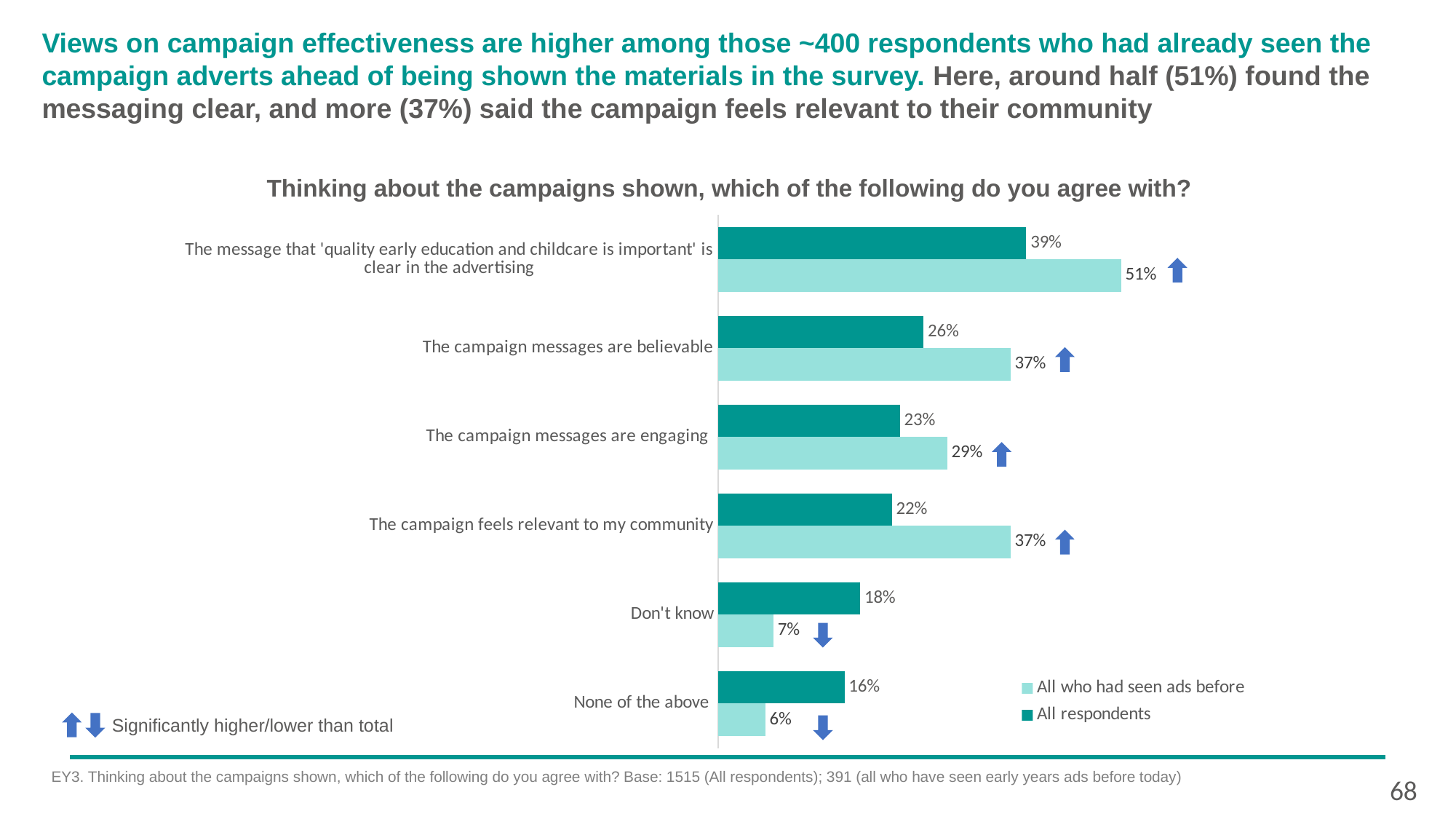
How many categories are shown on the chart? 6 What is the title of the chart? Thinking about the campaigns shown, which of the following do you agree with? Which category has the lowest value among all who had seen ads before? None of the above What percentage of all respondents agreed that the campaign messages are believable? 26% What percentage of all respondents selected 'Don't know'? 18% For 'Don't know', which group has the larger value: all respondents or all who had seen ads before? All respondents What is the difference between all who had seen ads before and all respondents for the statement that the message is clear in the advertising? 12 percentage points Which statement has the highest value among all who had seen ads before? The message that 'quality early education and childcare is important' is clear in the advertising For 'The campaign messages are engaging', which group has the larger value: all respondents or all who had seen ads before? All who had seen ads before What percentage of all who had seen ads before agreed that the campaign feels relevant to my community? 37% How many series does the legend list? 2 What type of chart is shown on the slide? Bar chart